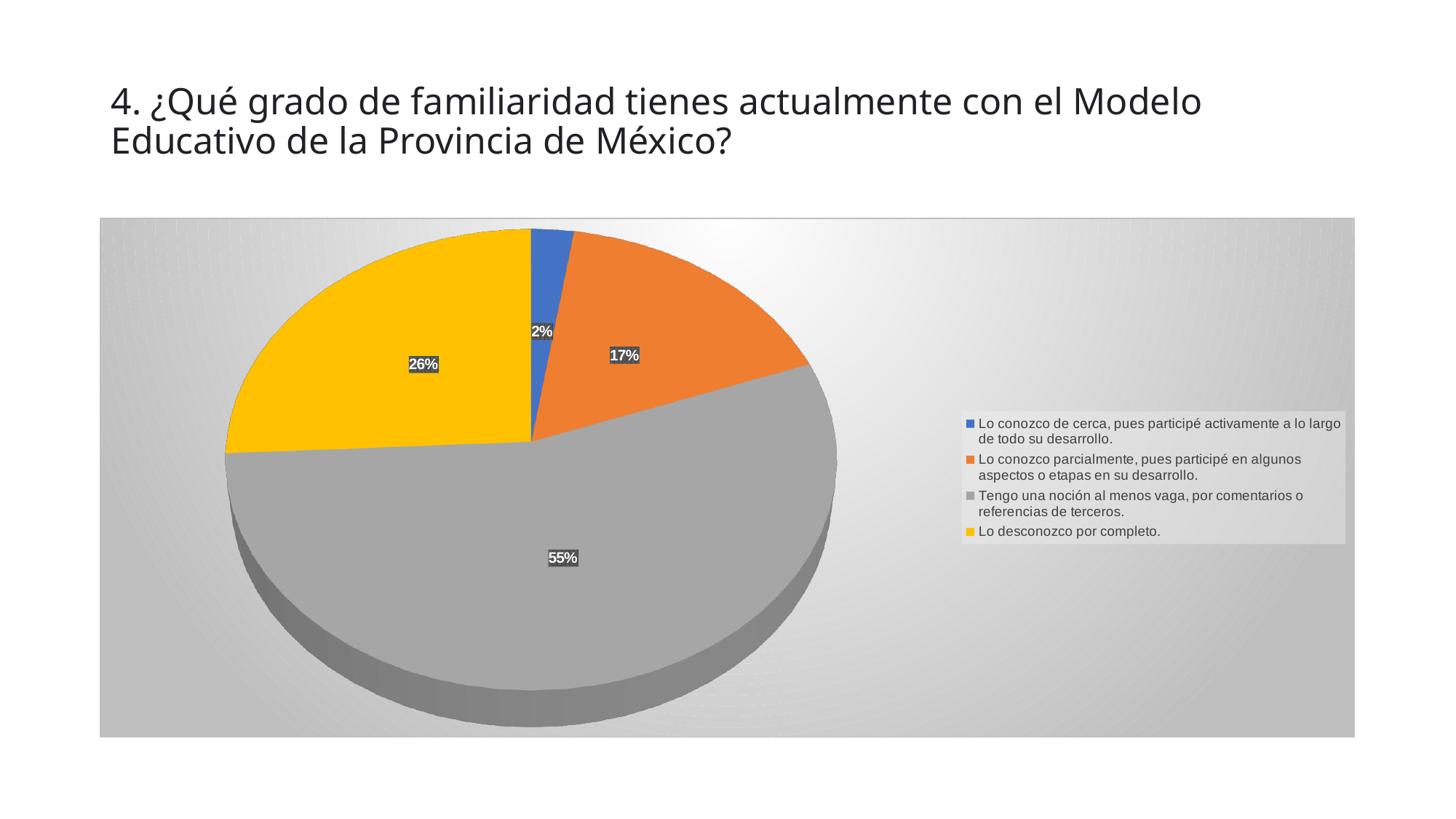
What kind of chart is shown on the slide? Pie chart What colour is the slice for "Lo desconozco por completo."? Yellow Which slice is larger: "Lo desconozco por completo." or "Lo conozco parcialmente, pues participé en algunos aspectos o etapas en su desarrollo."? Lo desconozco por completo. What is the difference in percentage points between the "Lo desconozco por completo." slice and the "Lo conozco parcialmente" slice? 9 percentage points Which category has the smallest slice of the pie? Lo conozco de cerca, pues participé activamente a lo largo de todo su desarrollo. What is the title of the slide above the chart? 4. ¿Qué grado de familiaridad tienes actualmente con el Modelo Educativo de la Provincia de México? Which category has the largest slice of the pie? Tengo una noción al menos vaga, por comentarios o referencias de terceros. What share of the pie is labelled for "Lo conozco parcialmente, pues participé en algunos aspectos o etapas en su desarrollo."? 17% What share of the pie is labelled for "Tengo una noción al menos vaga, por comentarios o referencias de terceros."? 55% How many categories does the pie chart show? 4 What share of the pie is labelled for "Lo desconozco por completo."? 26%